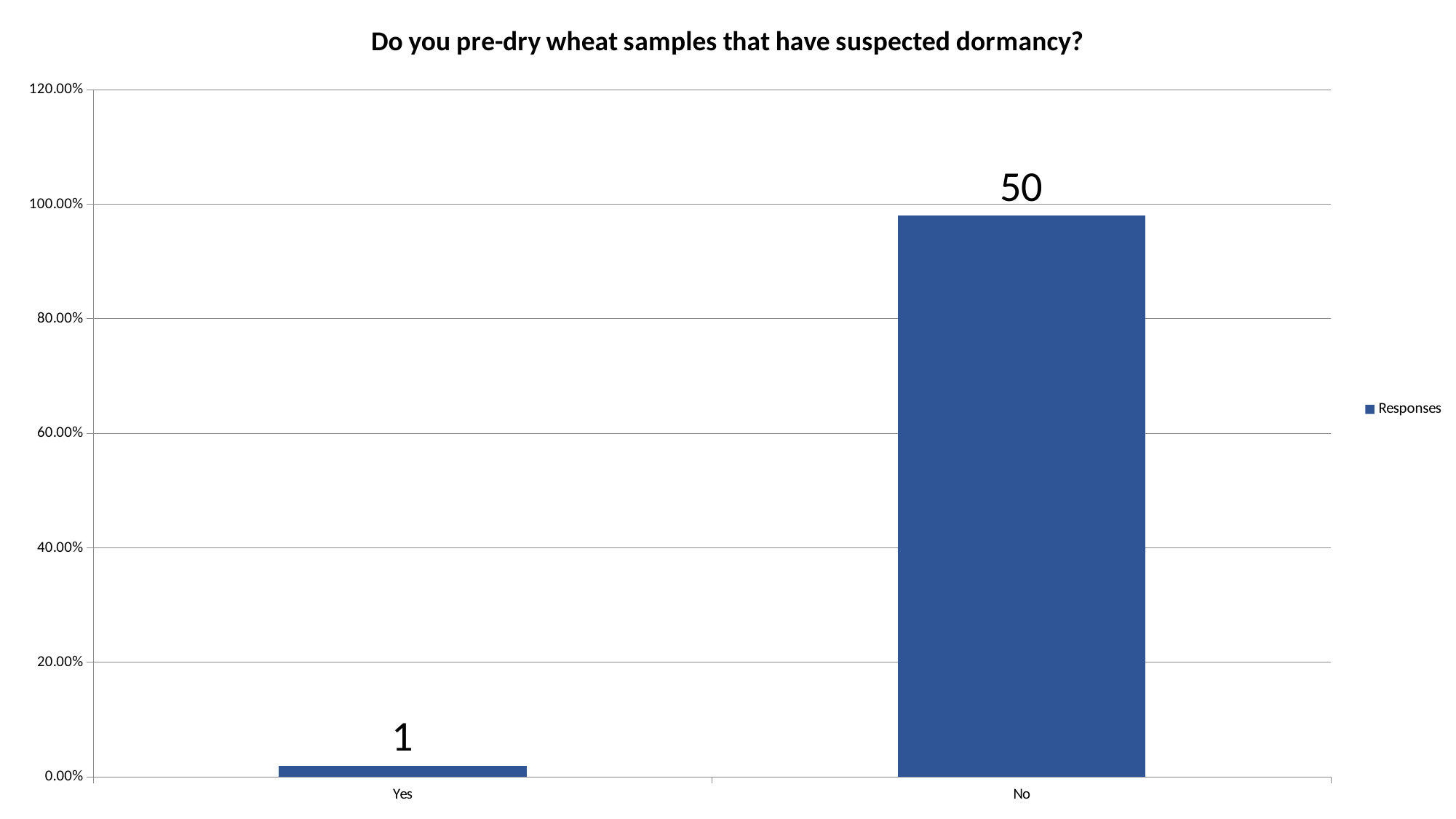
Is the value for "No" greater or less than 80.00%? greater Which category has the highest bar? No Which bar is taller, "Yes" or "No"? No What kind of chart is shown on the slide? bar chart What is the data label shown on the bar for "Yes"? 1 Is the value for "Yes" greater or less than 20.00%? less How many categories are shown on the x axis? 2 What is the difference between the data labels for "No" and "Yes"? 49 How many series does the legend list? 1 Which category has the lowest bar? Yes What is the data label shown on the bar for "No"? 50 What is the title of the chart? Do you pre-dry wheat samples that have suspected dormancy?